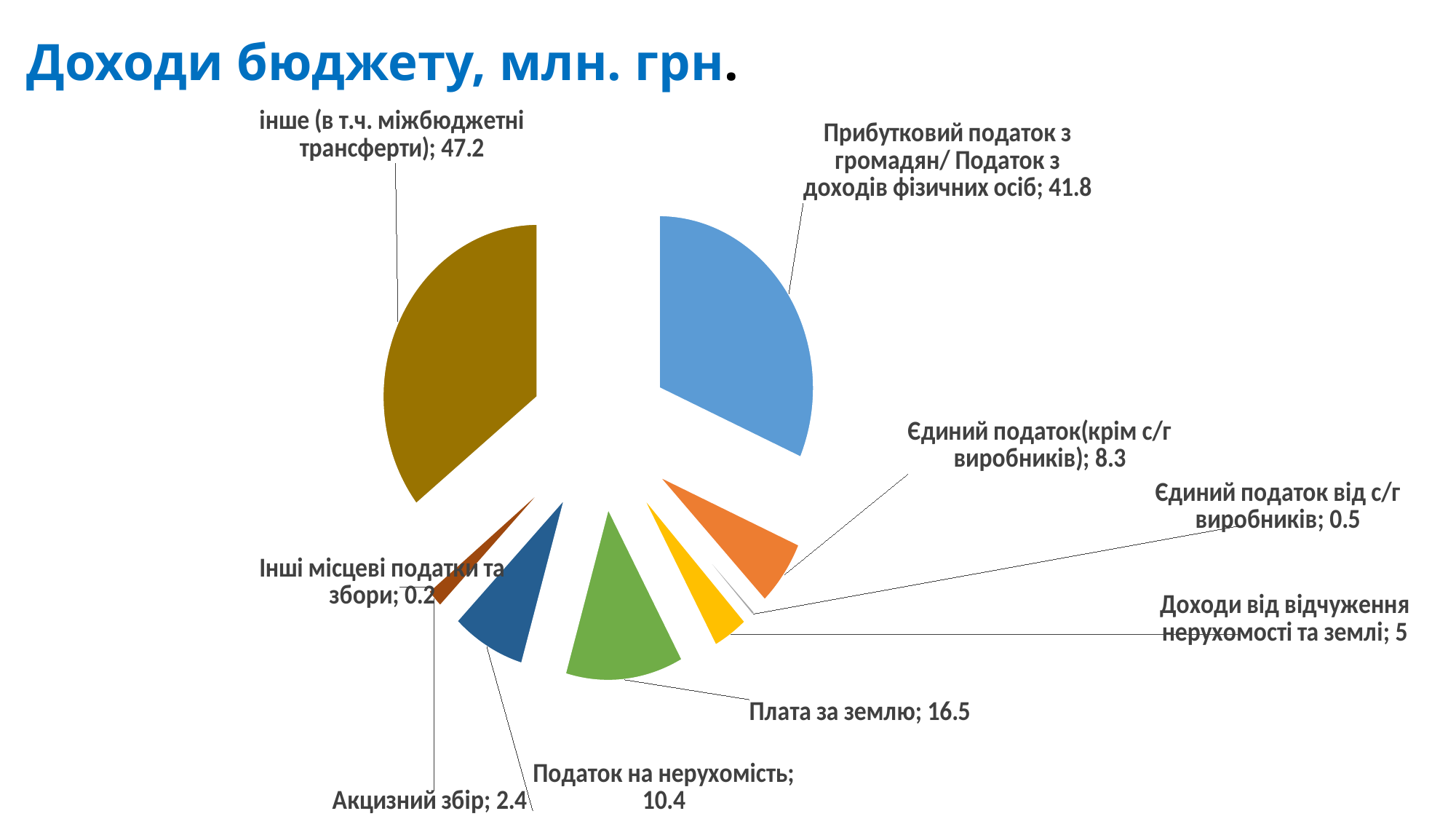
What kind of chart is shown on the slide? Pie chart Which category has the smallest value? Інші місцеві податки та збори What is the title of the chart? Доходи бюджету, млн. грн. What is the value for Акцизний збір? 2.4 What is the value for Податок на нерухомість? 10.4 Which category has the largest value? інше (в т.ч. міжбюджетні трансферти) What is the value for Єдиний податок від с/г виробників? 0.5 How many slices does the pie chart have? 9 What is the difference between the values for інше (в т.ч. міжбюджетні трансферти) and Прибутковий податок з громадян/ Податок з доходів фізичних осіб? 5.4 What is the value for Плата за землю? 16.5 What is the difference between the values for Єдиний податок(крім с/г виробників) and Доходи від відчуження нерухомості та землі? 3.3 Which is larger: Плата за землю or Податок на нерухомість? Плата за землю